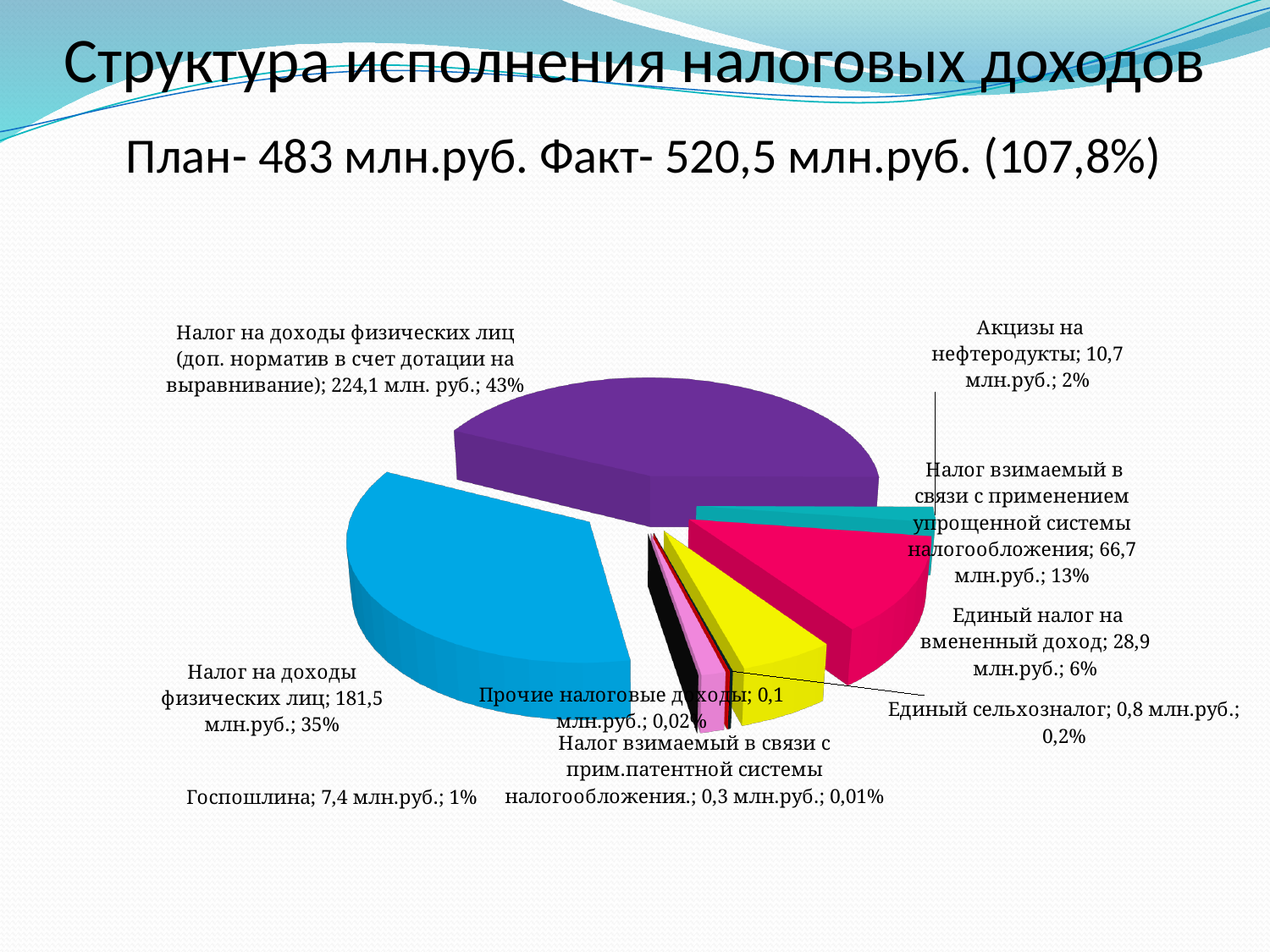
What share of the pie does Единый налог на вмененный доход represent? 6% What is the difference between Налог взимаемый в связи с применением упрощенной системы налогообложения (66,7 млн.руб.) and Единый налог на вмененный доход (28,9 млн.руб.)? 37,8 млн.руб. Which is larger: Акцизы на нефтеродукты or Госпошлина? Акцизы на нефтеродукты What is the title of the slide containing the chart? Структура исполнения налоговых доходов How many categories (slices) does the pie chart show? 9 What share of the pie does Налог на доходы физических лиц (181,5 млн.руб.) represent? 35% What is the value for Госпошлина? 7,4 млн.руб. Which category has the largest value in the pie chart? Налог на доходы физических лиц (доп. норматив в счет дотации на выравнивание) Which category has the smallest value in the pie chart? Прочие налоговые доходы What is the value for Налог взимаемый в связи с применением упрощенной системы налогообложения? 66,7 млн.руб. What kind of chart is shown on the slide? pie chart What is the value for Налог на доходы физических лиц (доп. норматив в счет дотации на выравнивание)? 224,1 млн. руб.